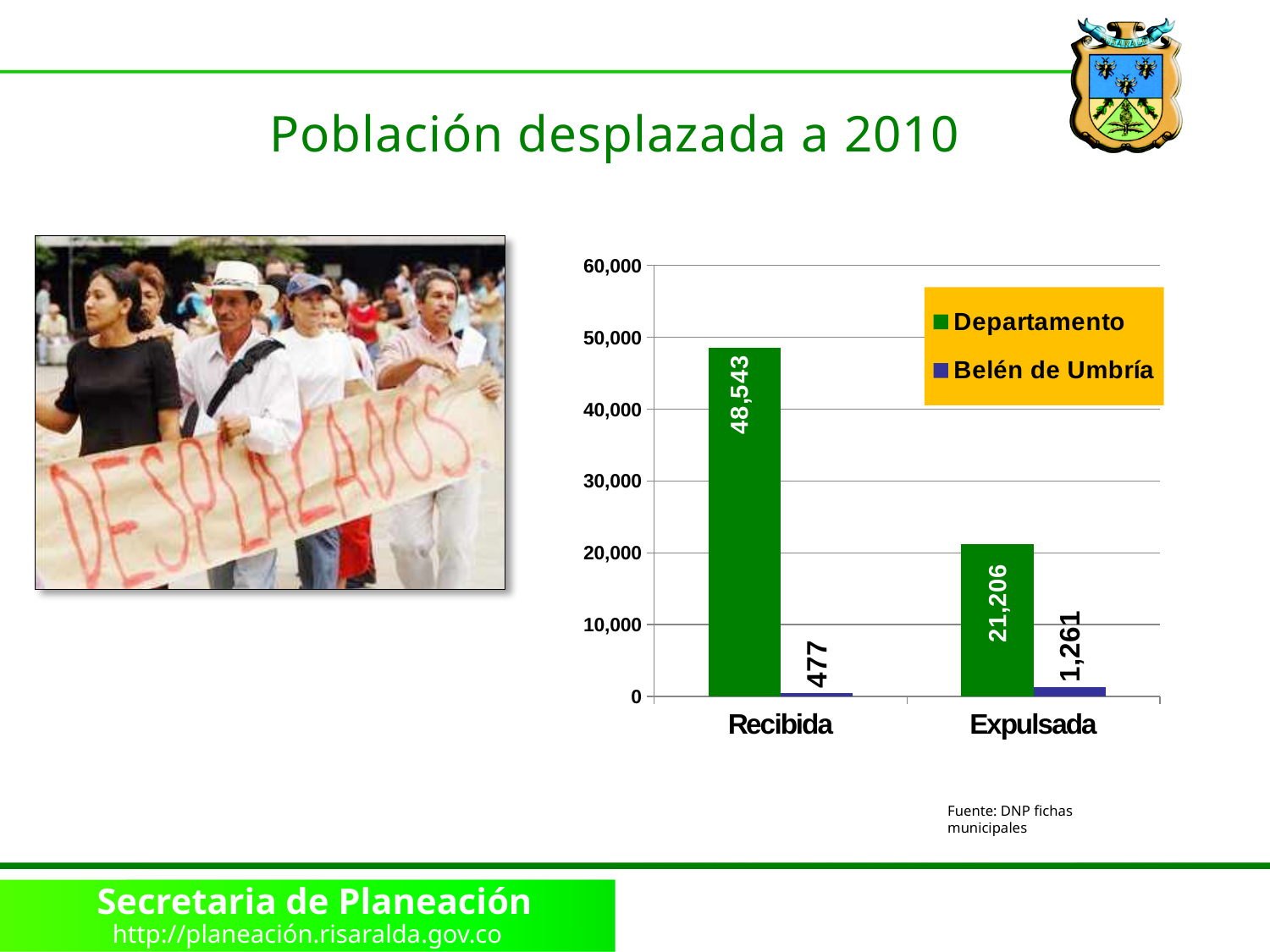
What is the value for Departamento in the Recibida category? 48,543 Which category has the highest Departamento value? Recibida How many series does the legend list? 2 Is the Departamento value for Expulsada greater or less than 30,000? less What is the difference between the Departamento values for Recibida and Expulsada? 27,337 What is the value for Belén de Umbría in the Expulsada category? 1,261 What kind of chart is shown on the slide? bar chart Which is larger: the Belén de Umbría value for Recibida or for Expulsada? Expulsada How many categories are shown on the x axis? 2 Which category has the lowest Belén de Umbría value? Recibida What is the value for Departamento in the Expulsada category? 21,206 What is the value for Belén de Umbría in the Recibida category? 477